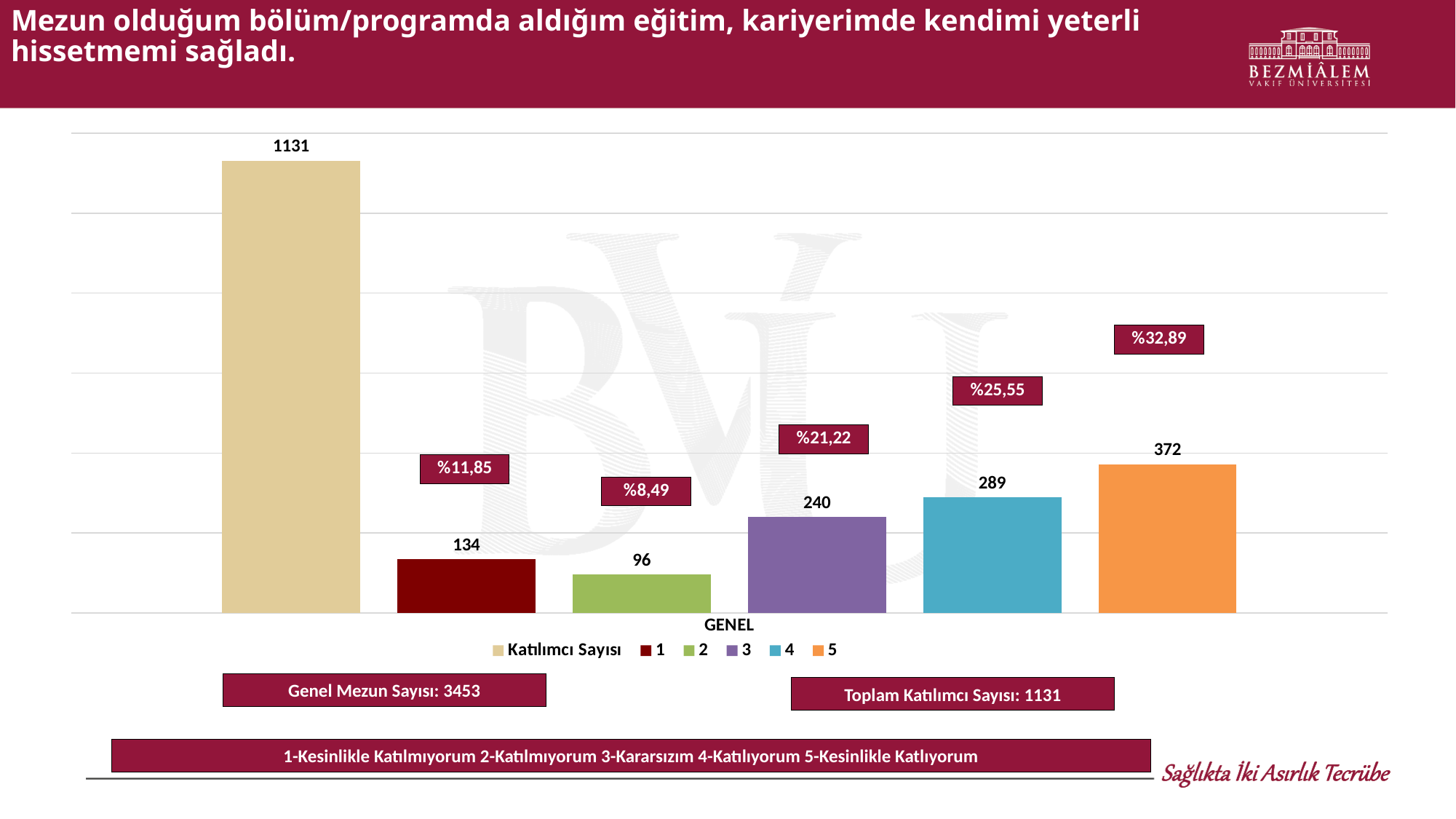
What is the value of the bar for series '3'? 240 Among the response series 1 to 5, which has the lowest value? 2 What is the difference between the values for series '5' and series '4'? 83 Which is larger, the value for series '1' or the value for series '3'? 3 Among the response series 1 to 5, which has the highest value? 5 What percentage label is shown above the bar for series '4'? %25,55 What is the category label shown on the x axis? GENEL What is the value of the bar for series '5'? 372 What kind of chart is shown on the slide? Bar chart What is the value of the 'Katılımcı Sayısı' bar? 1131 What is the value of the bar for series '2'? 96 How many series does the legend list? 6